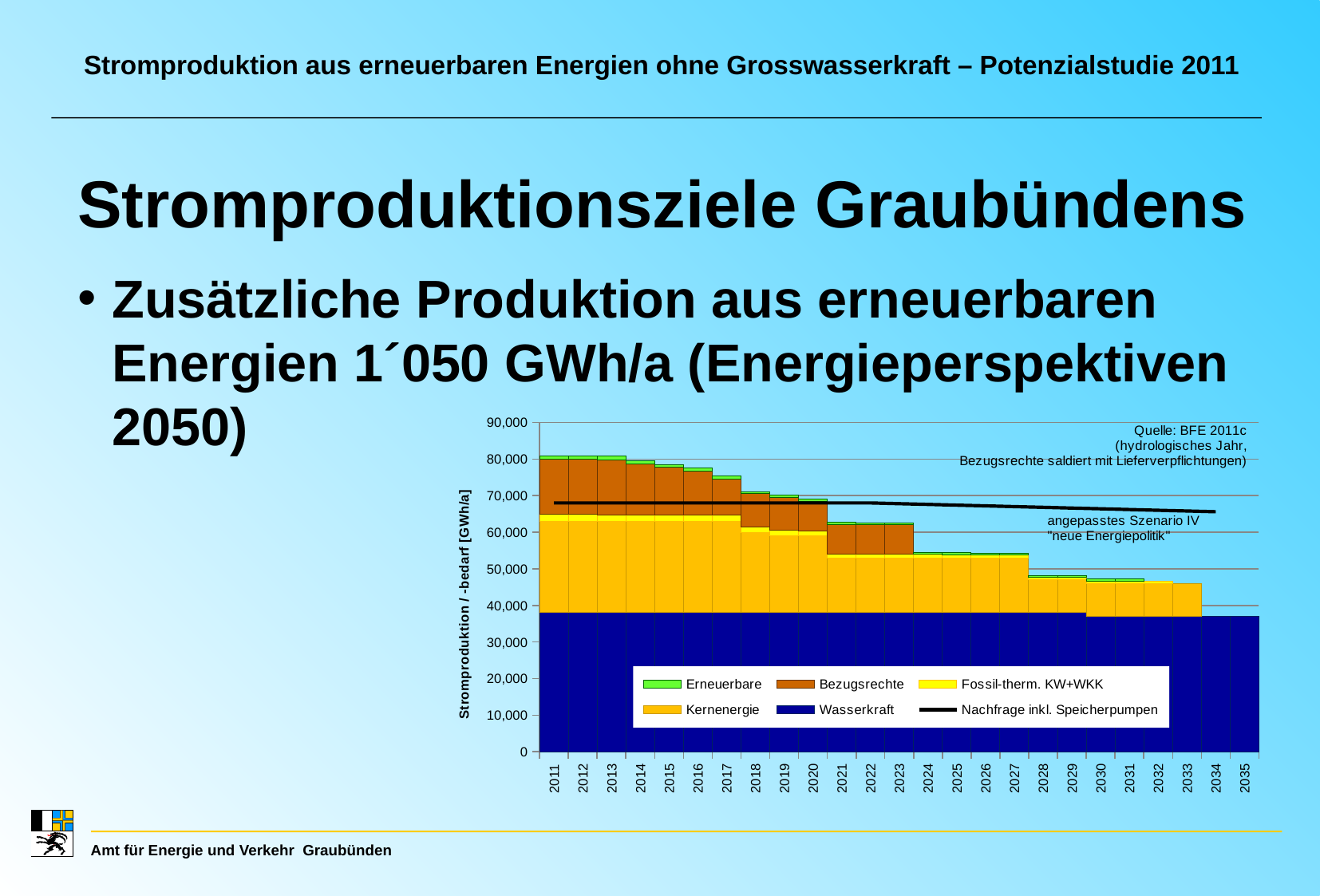
Is the total stacked bar for 2035 greater or less than 40,000? less Does the total stacked production in the chart rise or fall from 2011 to 2035? fall What is the label of the chart's y axis? Stromproduktion / -bedarf [GWh/a] Which year has the larger total stacked bar, 2011 or 2035? 2011 Is the total stacked bar for 2028 greater or less than 50,000? less Is the total stacked bar for 2021 greater or less than 60,000? greater What kind of chart is shown on the slide? stacked bar chart with a line (combination bar and line chart) Which legend entry is shown in dark blue? Wasserkraft How many years are shown along the x axis of the chart? 25 How many entries does the chart's legend list? 6